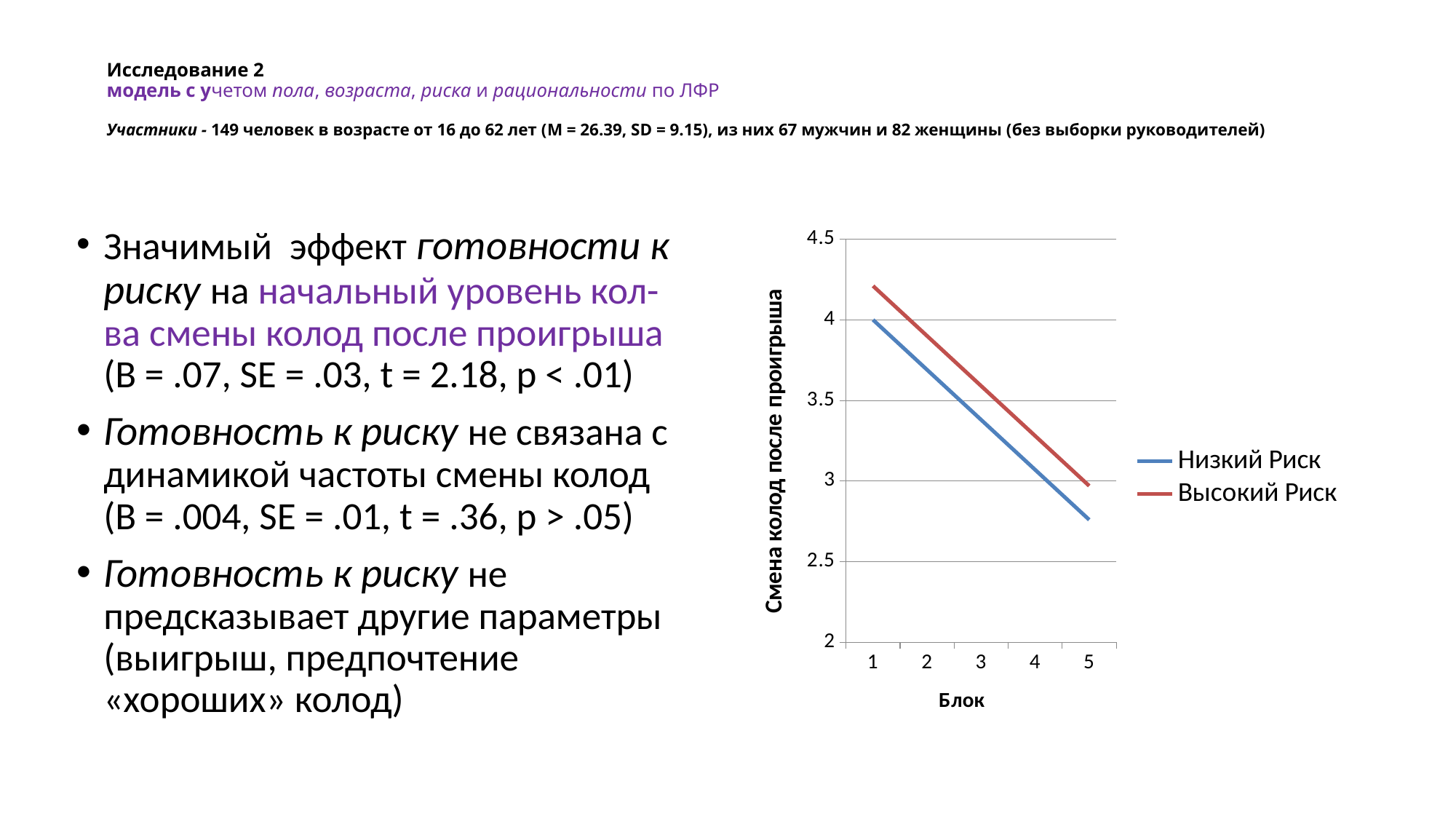
What kind of chart is shown on the slide? line chart How many series does the chart legend list? 2 Is the value for Низкий Риск at Блок 5 greater or less than 3? less How many block values are marked on the x axis of the chart? 5 What is the title of the y axis of the chart? Смена колод после проигрыша Do the values for Высокий Риск rise or fall along the x axis? fall Do the values for Низкий Риск rise or fall as Блок increases from 1 to 5? fall Is the value for Высокий Риск at Блок 1 greater or less than 4? greater At Блок 1, which series has the higher value: Низкий Риск or Высокий Риск? Высокий Риск Is the value for Низкий Риск at Блок 5 greater or less than 2.5? greater At Блок 5, which series has the higher value: Низкий Риск or Высокий Риск? Высокий Риск Which colour is used for the Высокий Риск line in the chart? red